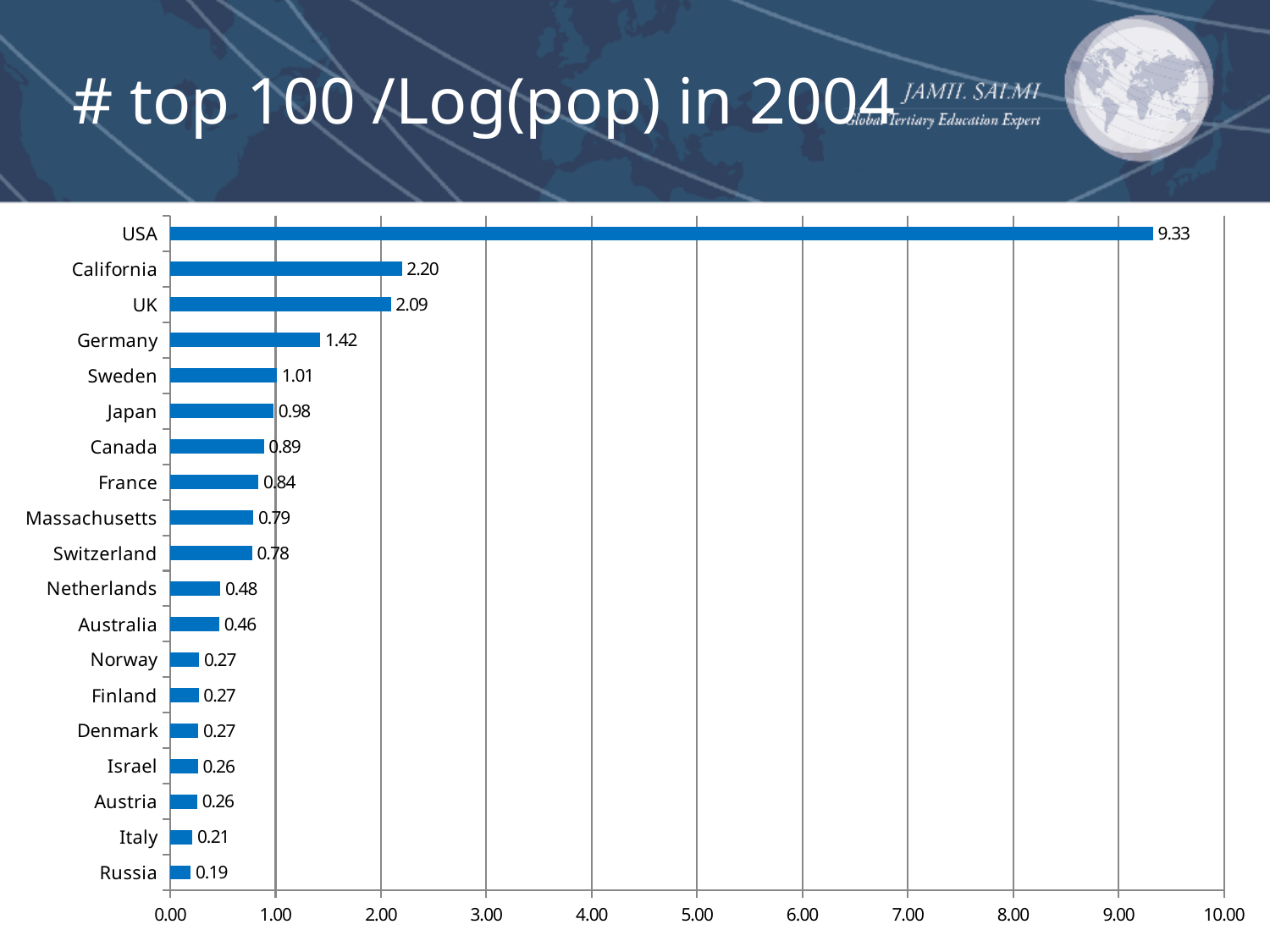
Which category has the highest value? USA What is the difference between the values for Sweden and Japan? 0.03 Which category has the lowest value? Russia Which is larger, the value for UK or the value for Germany? UK What is the value for Russia? 0.19 What is the title of the chart? # top 100 /Log(pop) in 2004 What is the value for Switzerland? 0.78 How many categories are shown in the chart? 19 What kind of chart is shown on the slide? bar chart What is the value for Germany? 1.42 What is the difference between the values for USA and California? 7.13 Is the value for Canada greater or less than 1.00? less